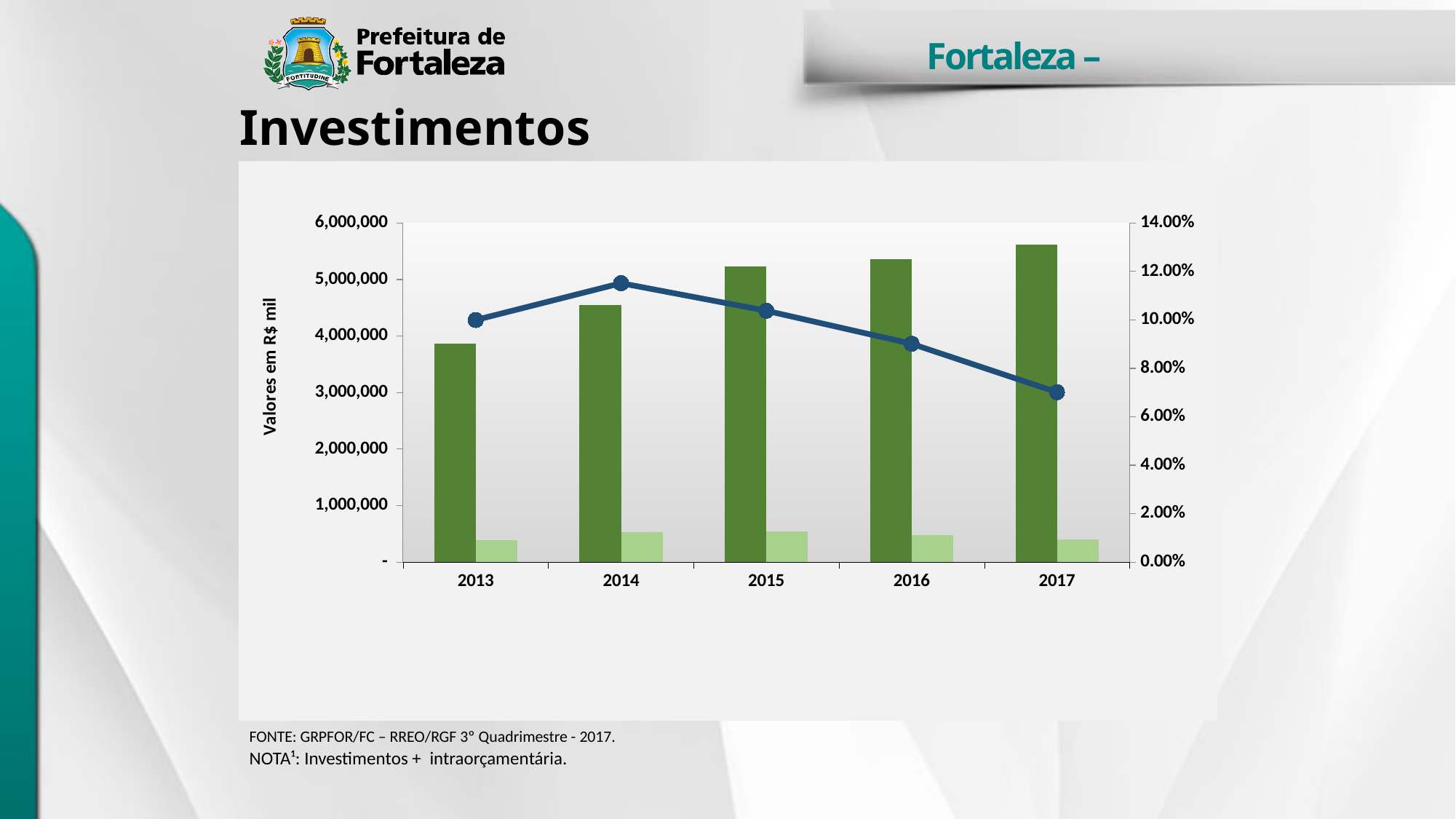
What is the label on the left vertical axis of the chart? Valores em R$ mil In which year does the blue line reach its highest point? 2014 Which dark green bar is taller, 2013 or 2014? 2014 In which year does the blue line reach its lowest point? 2017 In which year is the dark green bar the tallest? 2017 How many years are shown on the x axis of the chart? 5 Is the blue line value for 2017 greater or less than 8.00%? less What kind of chart is shown on the slide? A combination bar and line chart Is the dark green bar for 2013 greater or less than 4,000,000? less Do the dark green bars rise or fall from 2013 to 2017? Rise In which year is the dark green bar the shortest? 2013 Is the dark green bar for 2017 greater or less than 5,000,000? greater